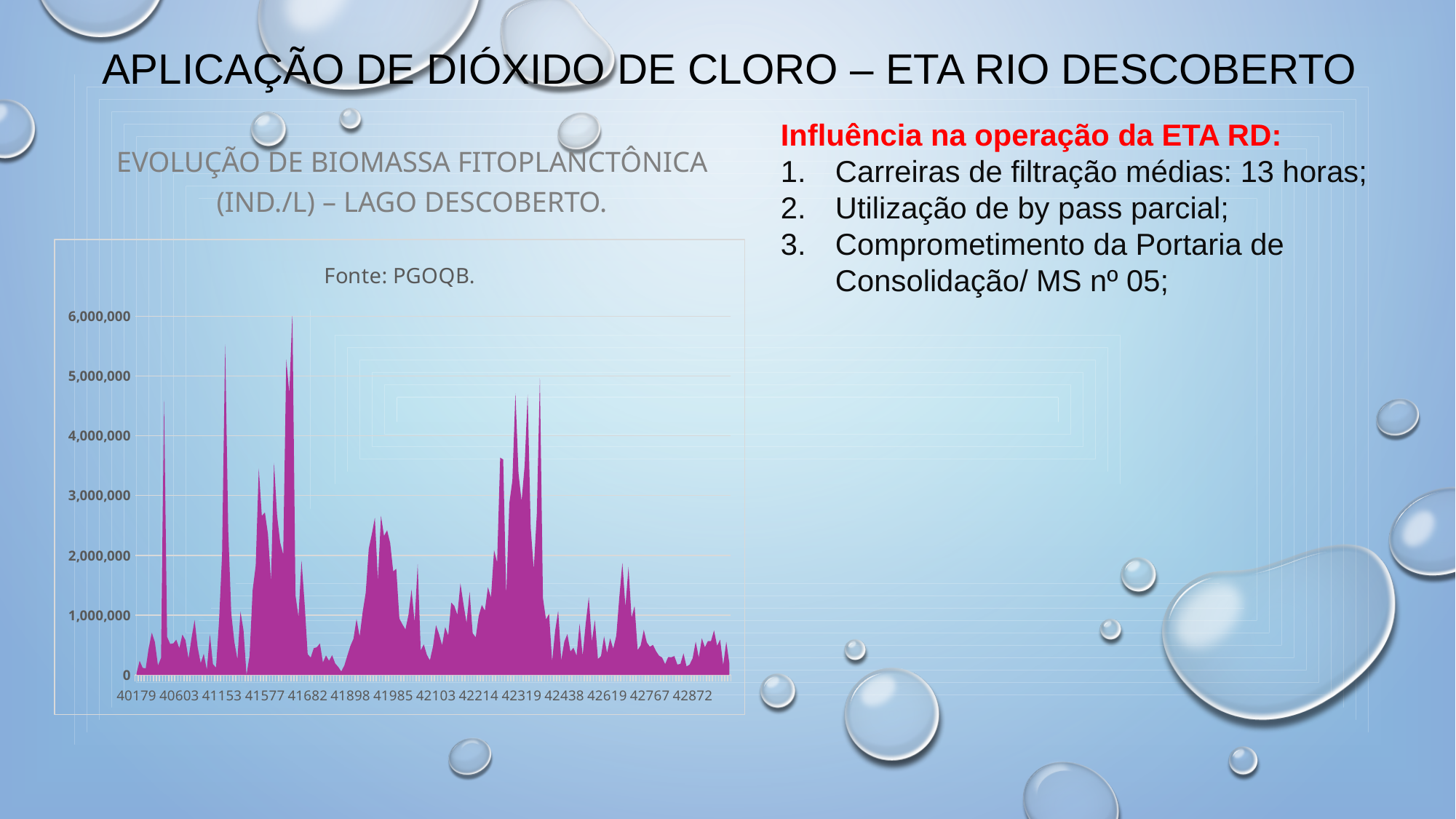
Is the value at the end of the series (at 42872) greater or less than 1,000,000? less What is the highest value labelled on the chart's vertical axis? 6,000,000 Is the highest peak of the plotted series greater or less than 5,000,000? greater What kind of chart is shown on the slide? Area chart What is the last label on the chart's horizontal axis? 42872 What is the first label on the chart's horizontal axis? 40179 What source is cited below the chart title? PGOQB. What is the interval between consecutive labels on the vertical axis? 1,000,000 How many labels are printed along the chart's horizontal axis? 14 What is the title of the chart? EVOLUÇÃO DE BIOMASSA FITOPLANCTÔNICA (IND./L) – LAGO DESCOBERTO. Is the value at the start of the series (at 40179) greater or less than 1,000,000? less